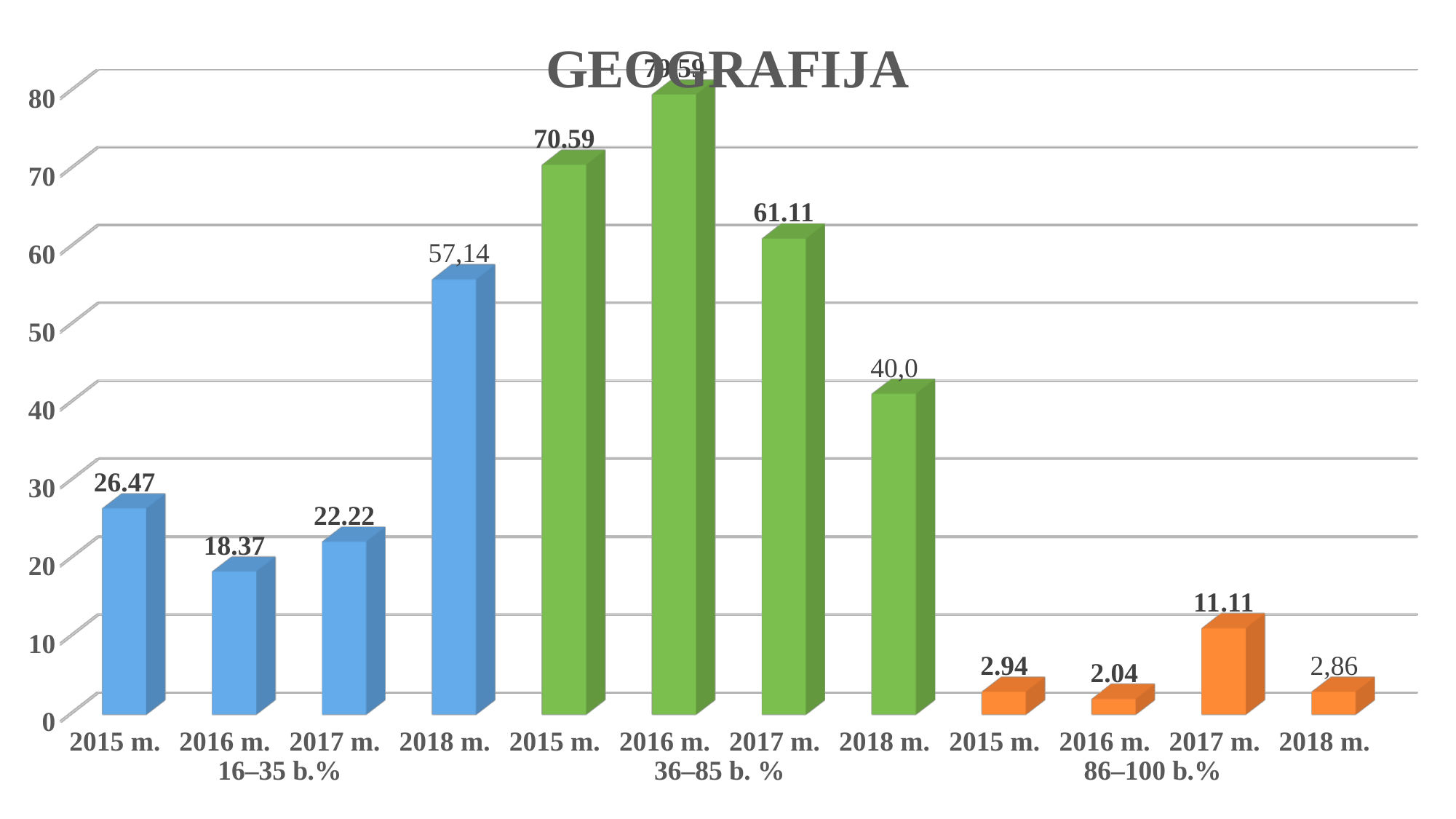
What is the value for 2018 m. in the 16–35 b.% group? 57,14 Which bar is the highest on the chart? 2016 m. in the 36–85 b. % group What is the value for 2015 m. in the 16–35 b.% group? 26.47 How many bars are plotted on the chart? 12 What is the value for 2018 m. in the 36–85 b. % group? 40,0 What is the title of the chart? GEOGRAFIJA What is the value for 2017 m. in the 36–85 b. % group? 61.11 What is the value for 2017 m. in the 86–100 b.% group? 11.11 What is the difference between the 2015 m. and 2016 m. values in the 16–35 b.% group? 8.10 Is the value for 2016 m. in the 36–85 b. % group greater or less than 70? greater Which is larger: the 2015 m. value in the 36–85 b. % group or the 2017 m. value in the same group? 2015 m. Which bar is the lowest on the chart? 2016 m. in the 86–100 b.% group